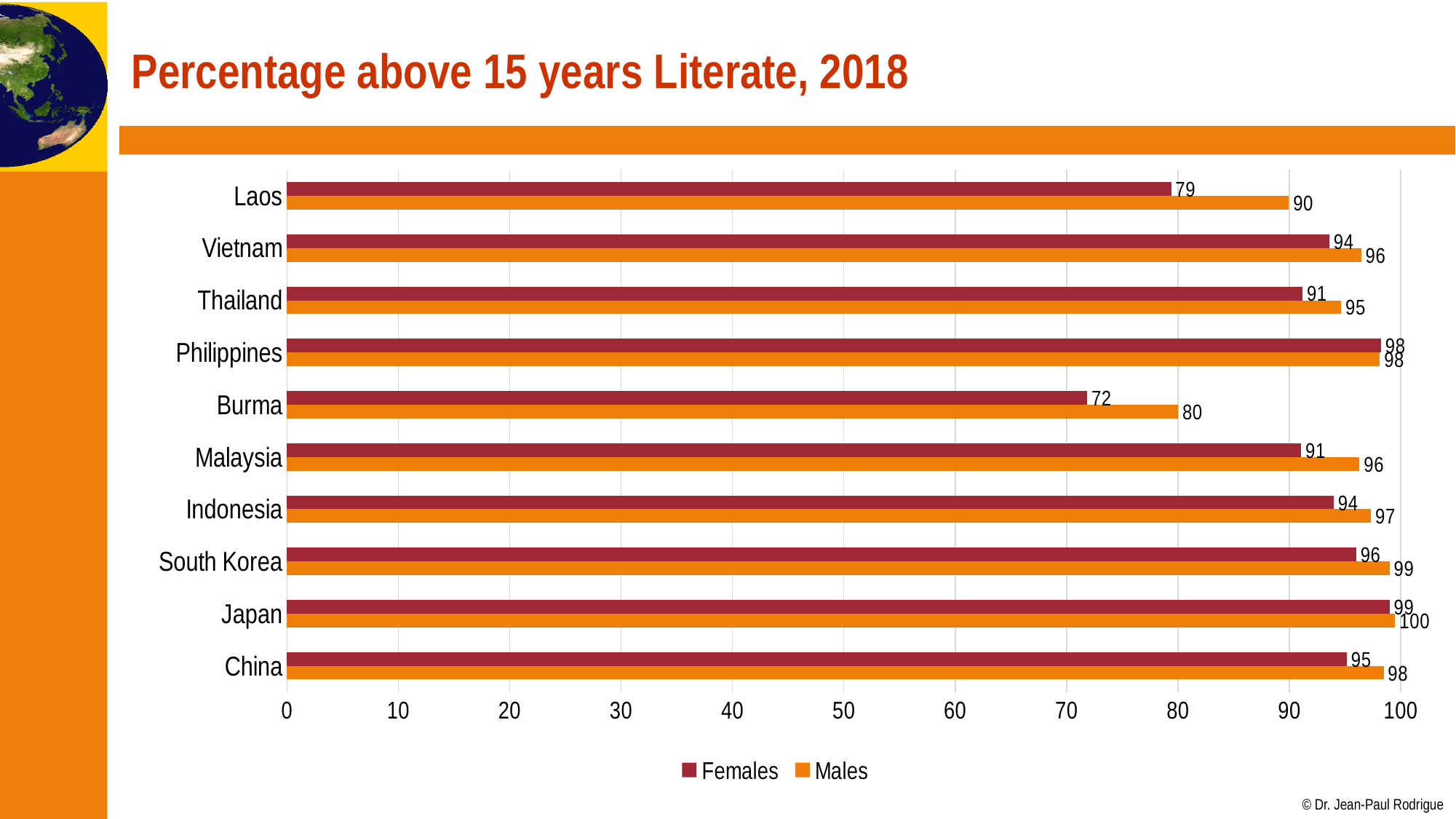
What is the title of the slide? Percentage above 15 years Literate, 2018 What is the Males value for Burma? 80 What is the Females value for Laos? 79 What is the difference between the Males and Females values for Burma? 8 Which country has the highest Males value? Japan How many series does the legend list? 2 What is the Males value for Japan? 100 How many countries are shown on the chart? 10 What kind of chart is shown on the slide? Bar chart Which country has the lowest Females value? Burma Which is larger, the Females value for Vietnam or the Females value for Thailand? Vietnam What is the difference between the Males and Females values for Laos? 11